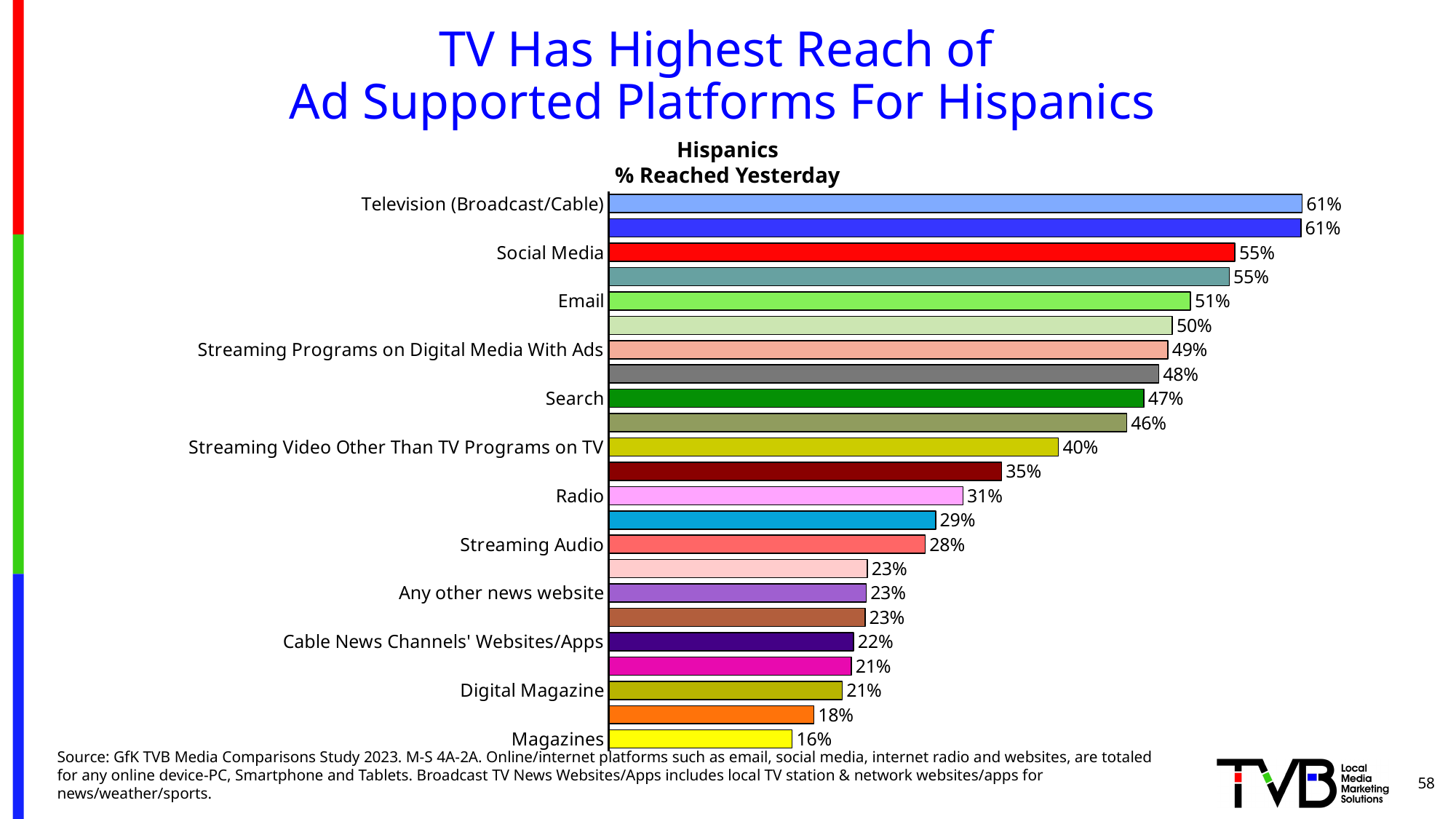
What is the difference between the values for Television (Broadcast/Cable) and Magazines? 45 percentage points What is the value for Social Media? 55% What is the value for Radio? 31% What is the value for Streaming Programs on Digital Media With Ads? 49% What is the value for Cable News Channels' Websites/Apps? 22% Which has a larger value, Search or Streaming Audio? Search What is the value for Television (Broadcast/Cable)? 61% What is the title printed above the chart? Hispanics % Reached Yesterday What is the highest value shown on the chart? 61% Which labeled category has the lowest value? Magazines What kind of chart is shown on the slide? Bar chart What is the difference between the values for Email and Search? 4 percentage points